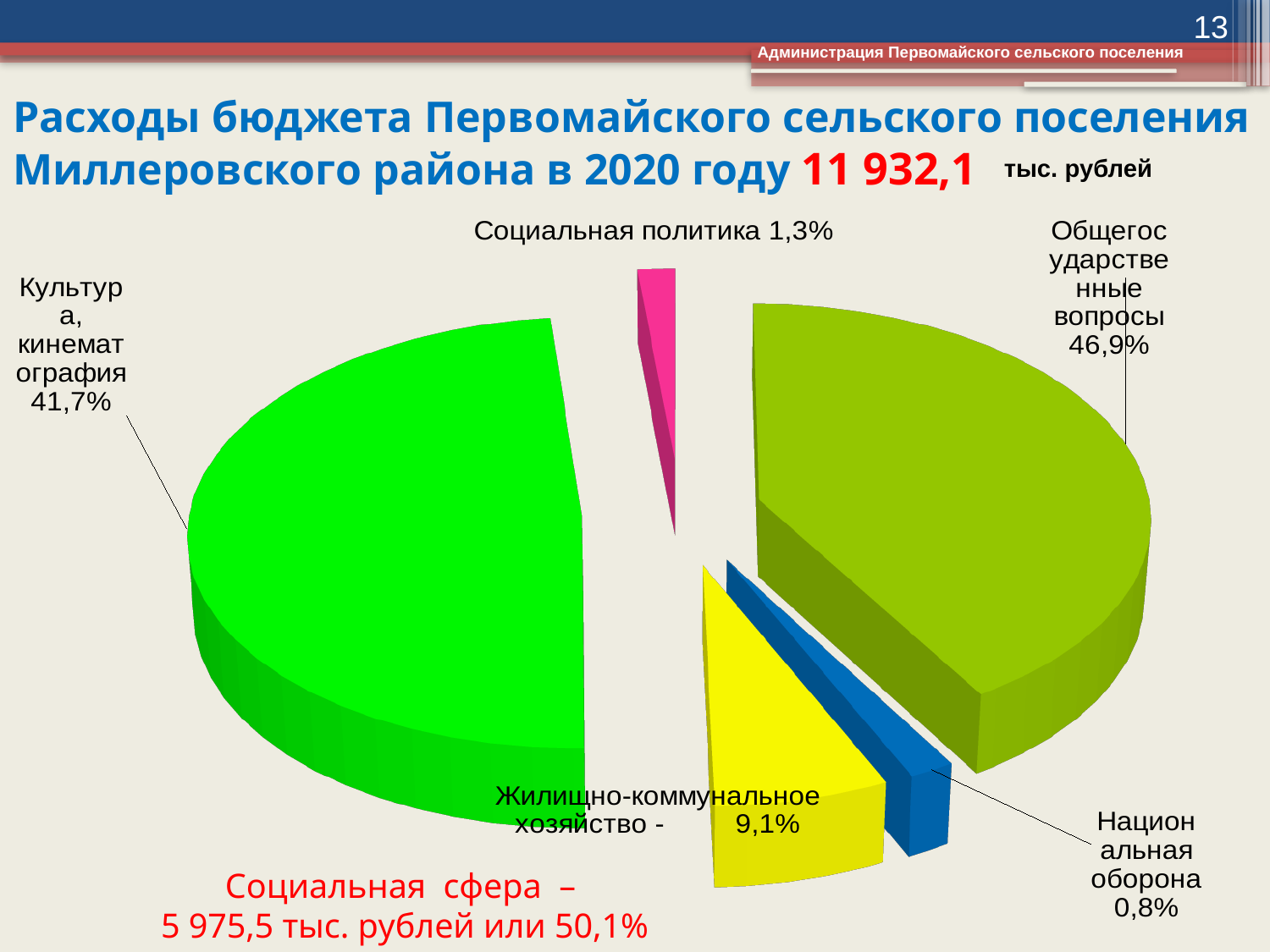
What kind of chart is shown on the slide? pie chart Which category has the largest share of the budget expenses? Общегосударственные вопросы What total amount of budget expenses in 2020 is stated in the slide title? 11 932,1 тыс. рублей What share of the budget expenses goes to Жилищно-коммунальное хозяйство? 9,1% What share of the budget expenses goes to Социальная политика? 1,3% What is the difference in percentage points between Общегосударственные вопросы and Культура, кинематография? 5,2 How many slices does the pie chart have? 5 Which is larger: the share for Жилищно-коммунальное хозяйство or the share for Социальная политика? Жилищно-коммунальное хозяйство What share of the budget expenses goes to Культура, кинематография? 41,7% Which category has the smallest share of the budget expenses? Национальная оборона What share of the budget expenses goes to Общегосударственные вопросы? 46,9% What share of the budget expenses goes to Национальная оборона? 0,8%